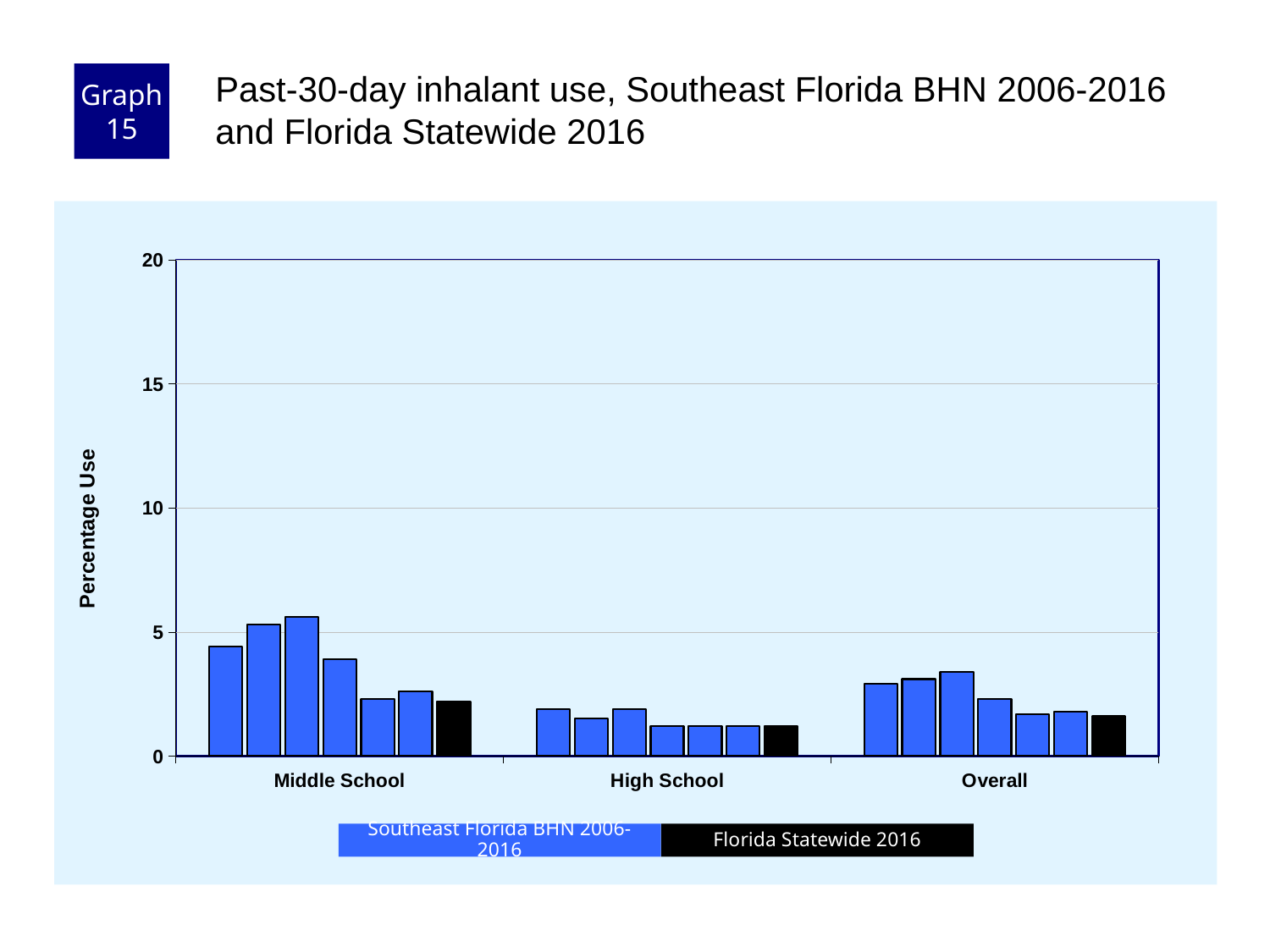
What kind of chart is shown on the slide? bar chart What is the label on the y axis? Percentage Use Which is larger, the Florida Statewide 2016 value for Middle School or for High School? Middle School How many categories are shown on the x axis? 3 How many series does the legend list? 2 Is the Florida Statewide 2016 value for Middle School greater or less than 5? less Are all the bars for Overall greater or less than 5? less Which colour represents Florida Statewide 2016 in the legend? black Which category has the lowest Florida Statewide 2016 value? High School Is the Florida Statewide 2016 value for High School greater or less than 5? less Which is larger, the Florida Statewide 2016 value for Overall or for High School? Overall